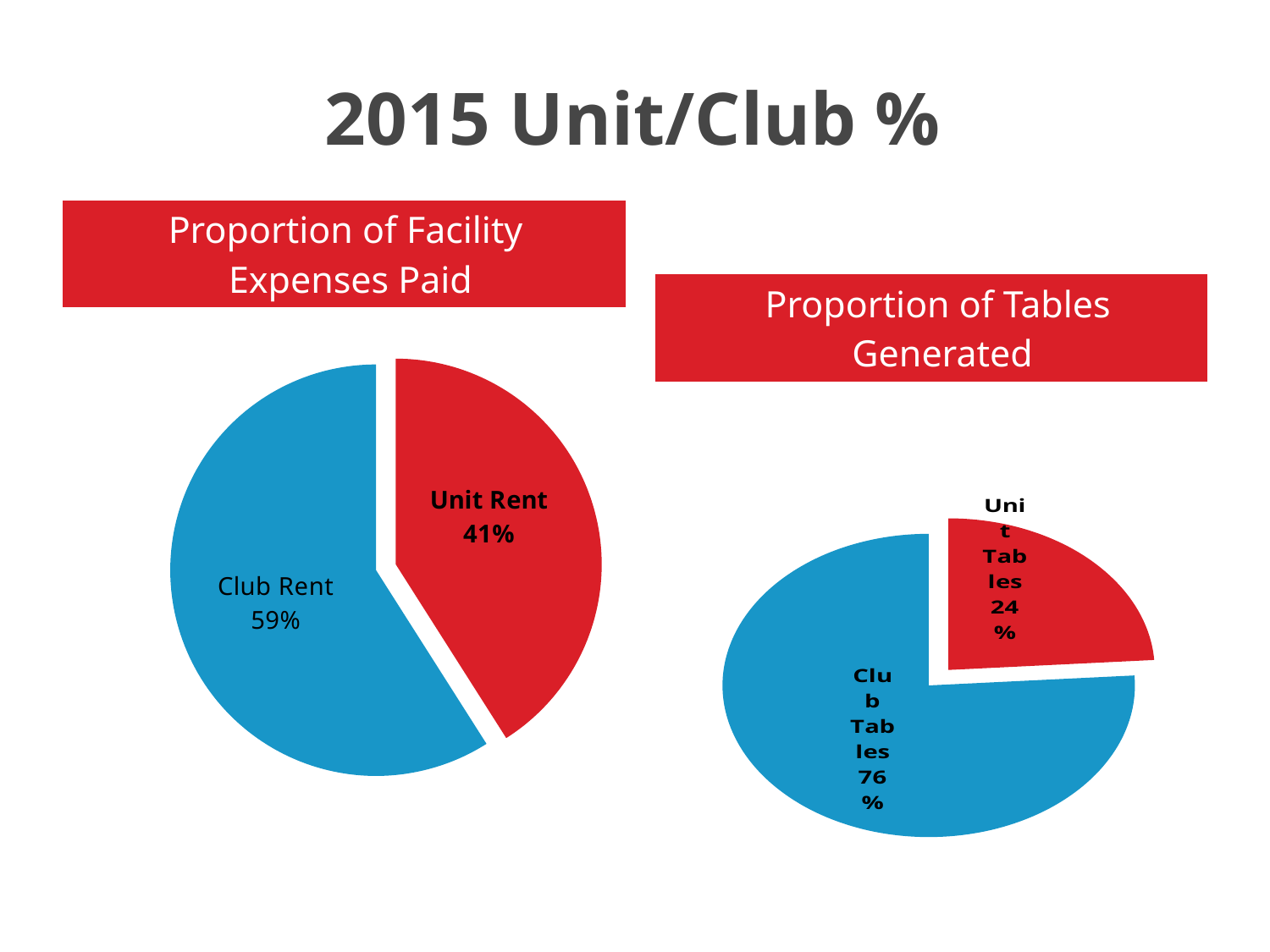
What is the title of the slide? 2015 Unit/Club % In the 'Proportion of Facility Expenses Paid' chart, what percentage is shown for Unit Rent? 41% How many slices does the 'Proportion of Facility Expenses Paid' chart have? 2 In the 'Proportion of Facility Expenses Paid' chart, what percentage is shown for Club Rent? 59% In the 'Proportion of Tables Generated' chart, what percentage is shown for Unit Tables? 24% What type of chart is the 'Proportion of Tables Generated' chart? Pie chart In the 'Proportion of Facility Expenses Paid' chart, which slice is the largest? Club Rent In the 'Proportion of Tables Generated' chart, which is larger, Club Tables or Unit Tables? Club Tables In the 'Proportion of Tables Generated' chart, what is the difference in percentage points between Club Tables and Unit Tables? 52 In the 'Proportion of Tables Generated' chart, what percentage is shown for Club Tables? 76% In the 'Proportion of Tables Generated' chart, which slice is the smallest? Unit Tables In the 'Proportion of Facility Expenses Paid' chart, what is the difference in percentage points between Club Rent and Unit Rent? 18